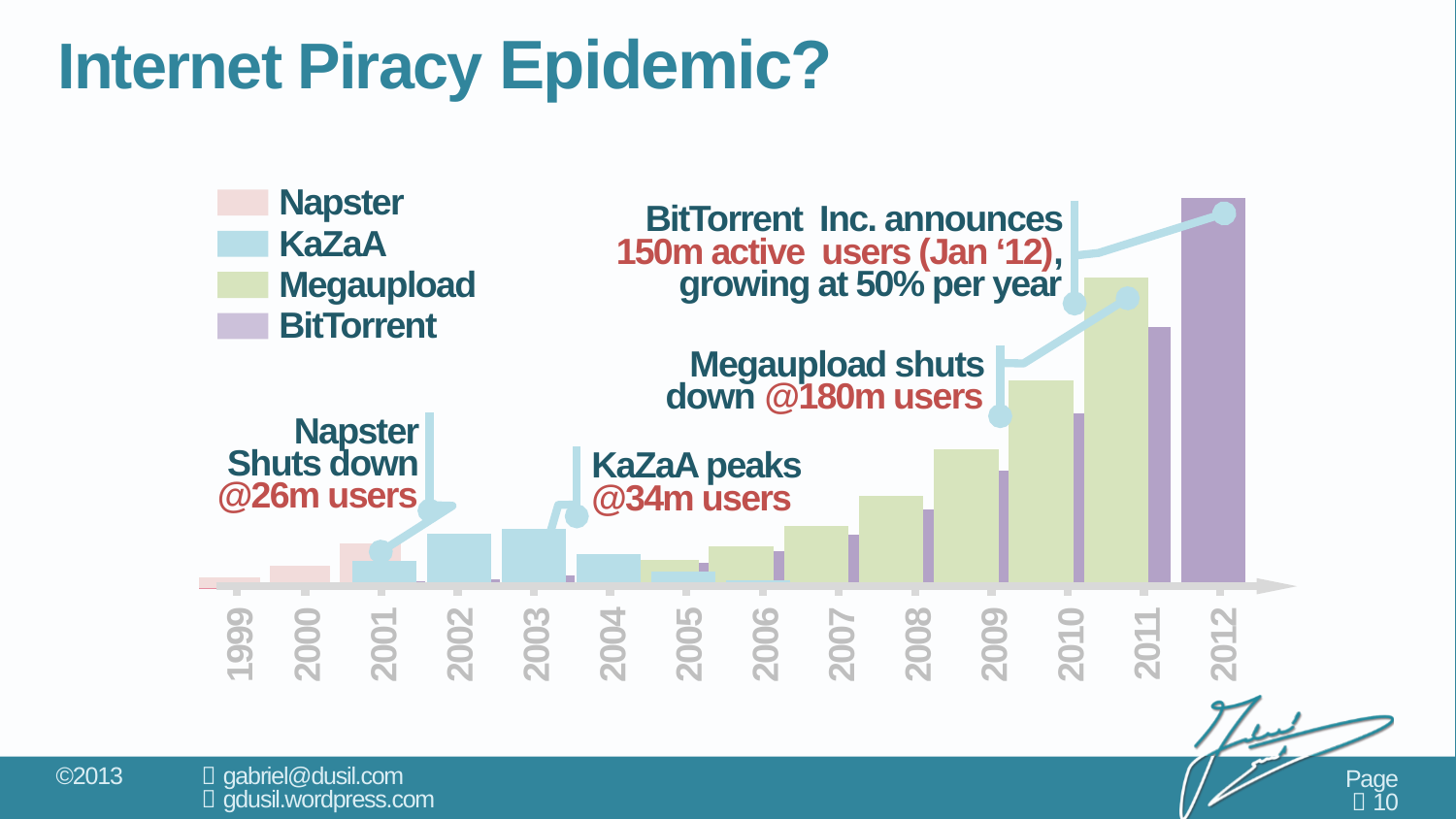
According to the annotation, how many users did Megaupload have when it shut down? 180m users How many series does the legend list? 4 Which series is listed first in the legend? Napster In 2011, which bar is taller: Megaupload or BitTorrent? Megaupload How many active users did BitTorrent Inc. announce in Jan '12? 150m What colour represents BitTorrent in the chart? purple Do the BitTorrent bars rise or fall from 2005 to 2012? rise How many years are shown along the x axis? 14 What kind of chart is shown on the slide? bar chart Which year has the tallest bar in the chart? 2012 According to the annotation, at how many users did KaZaA peak? 34m users According to the annotation, how many users did Napster have when it shut down? 26m users